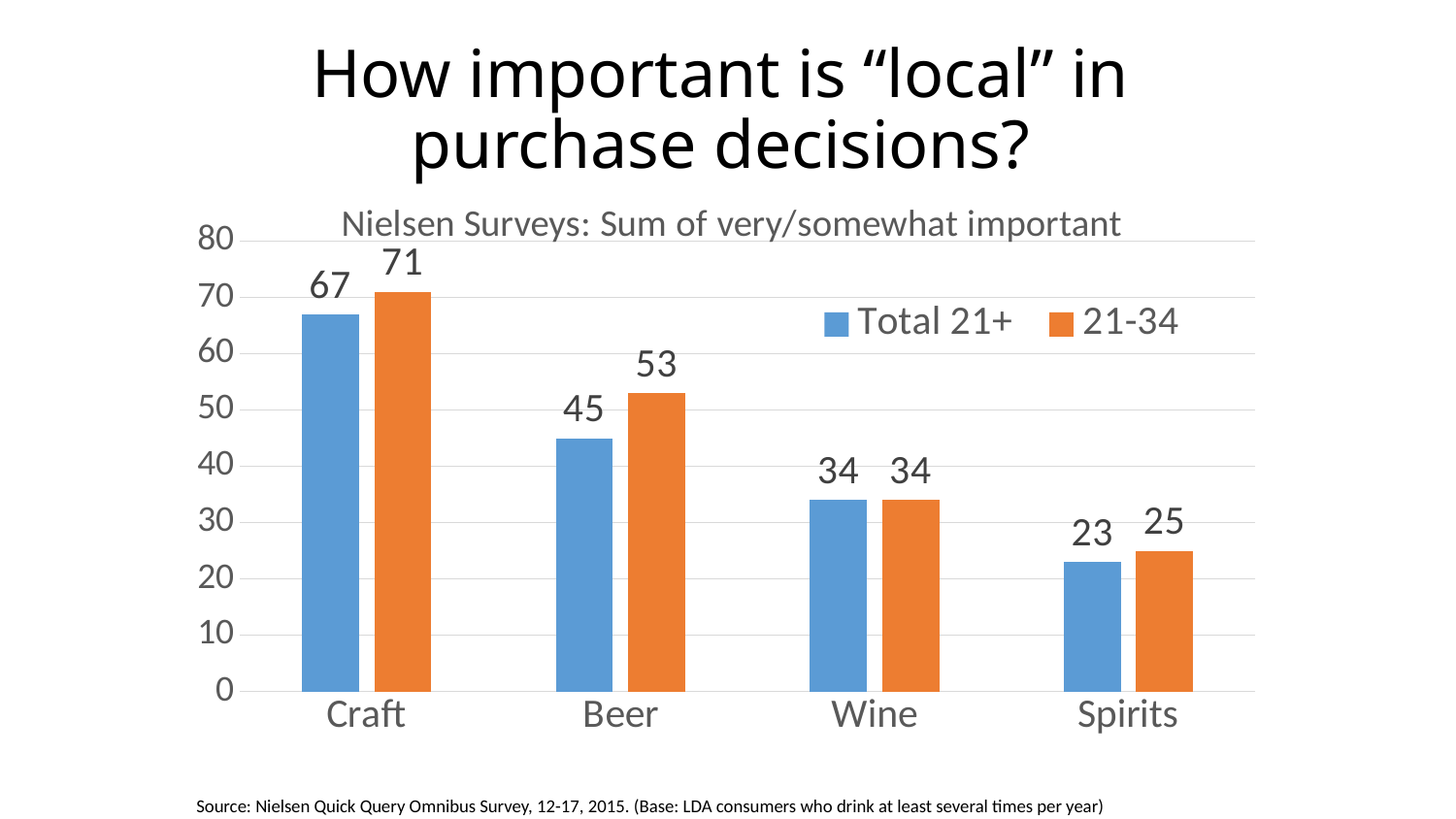
How many series does the legend list? 2 Which category has the highest value for the 21-34 series? Craft What kind of chart is shown on the slide? Bar chart What is the chart's title? Nielsen Surveys: Sum of very/somewhat important What is the difference between the 21-34 and Total 21+ values for Beer? 8 Do the Total 21+ values rise or fall from Craft to Spirits along the x axis? Fall What is the value for Total 21+ for Craft? 67 What is the value for 21-34 for Spirits? 25 Which category has the lowest value for the Total 21+ series? Spirits How many categories are shown on the x axis? 4 Which is larger for Craft: the Total 21+ value or the 21-34 value? 21-34 What is the value for 21-34 for Beer? 53